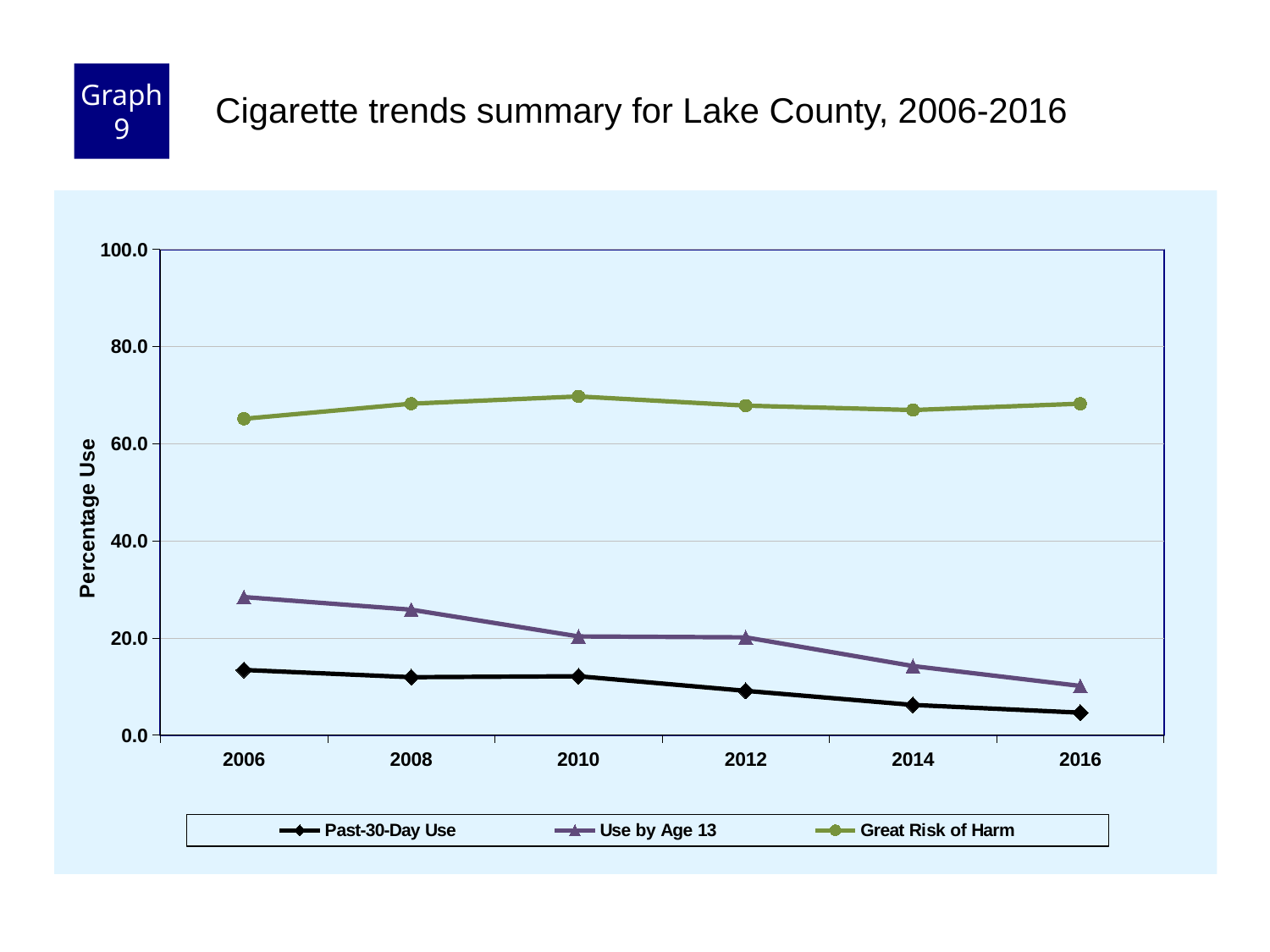
What is the label on the y axis? Percentage Use Is the value for Past-30-Day Use in 2016 greater or less than 20.0? less How many years are plotted along the x axis? 6 How many series does the legend list? 3 What kind of chart is shown on the slide? line chart Is the value for Use by Age 13 in 2006 greater or less than 20.0? greater In which year is the Use by Age 13 series highest? 2006 Does the Use by Age 13 series rise or fall from 2006 to 2016? fall In 2012, which is larger: Great Risk of Harm or Past-30-Day Use? Great Risk of Harm Does the Past-30-Day Use series rise or fall from 2006 to 2016? fall Is the value for Great Risk of Harm in 2010 greater or less than 60.0? greater In which year is the Past-30-Day Use series lowest? 2016